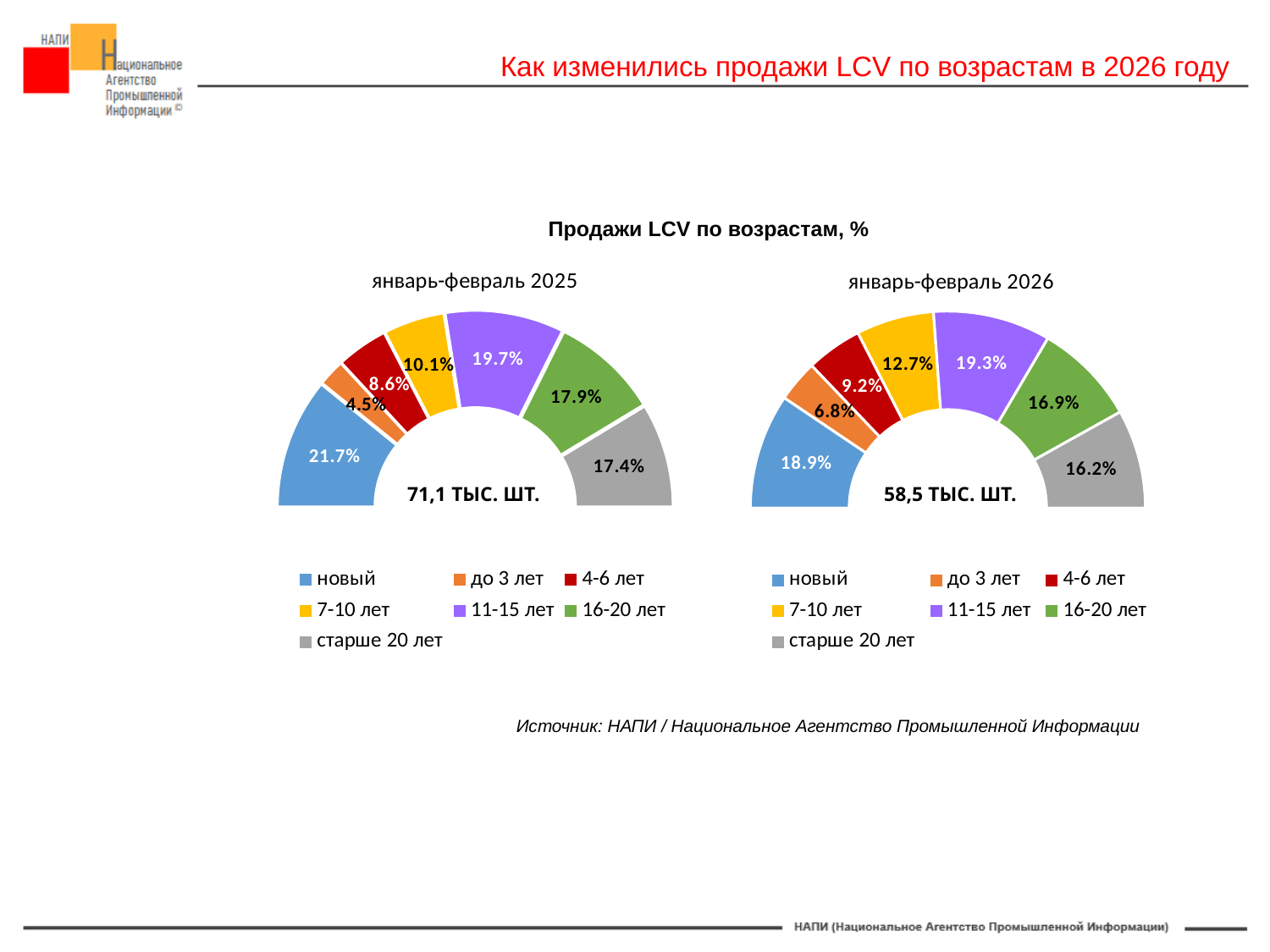
In the январь-февраль 2026 chart, which category has the smallest share? до 3 лет What kind of chart is used to show the LCV sales by age? Pie (doughnut) chart In the январь-февраль 2026 chart, which category has the largest share? 11-15 лет In the январь-февраль 2025 chart, which is larger: the share of 16-20 лет or the share of старше 20 лет? 16-20 лет In the январь-февраль 2026 chart, what share is shown for the до 3 лет category? 6.8% What total volume is printed in the centre of the январь-февраль 2025 chart? 71,1 ТЫС. ШТ. In the январь-февраль 2025 chart, which category has the largest share? новый How many categories does the legend of the январь-февраль 2026 chart list? 7 In the январь-февраль 2026 chart, what share is shown for the 7-10 лет category? 12.7% In the январь-февраль 2025 chart, what share is shown for the новый category? 21.7% What is the difference between the share of новый in январь-февраль 2025 and in январь-февраль 2026? 2.8 percentage points In the январь-февраль 2025 chart, which category has the smallest share? до 3 лет